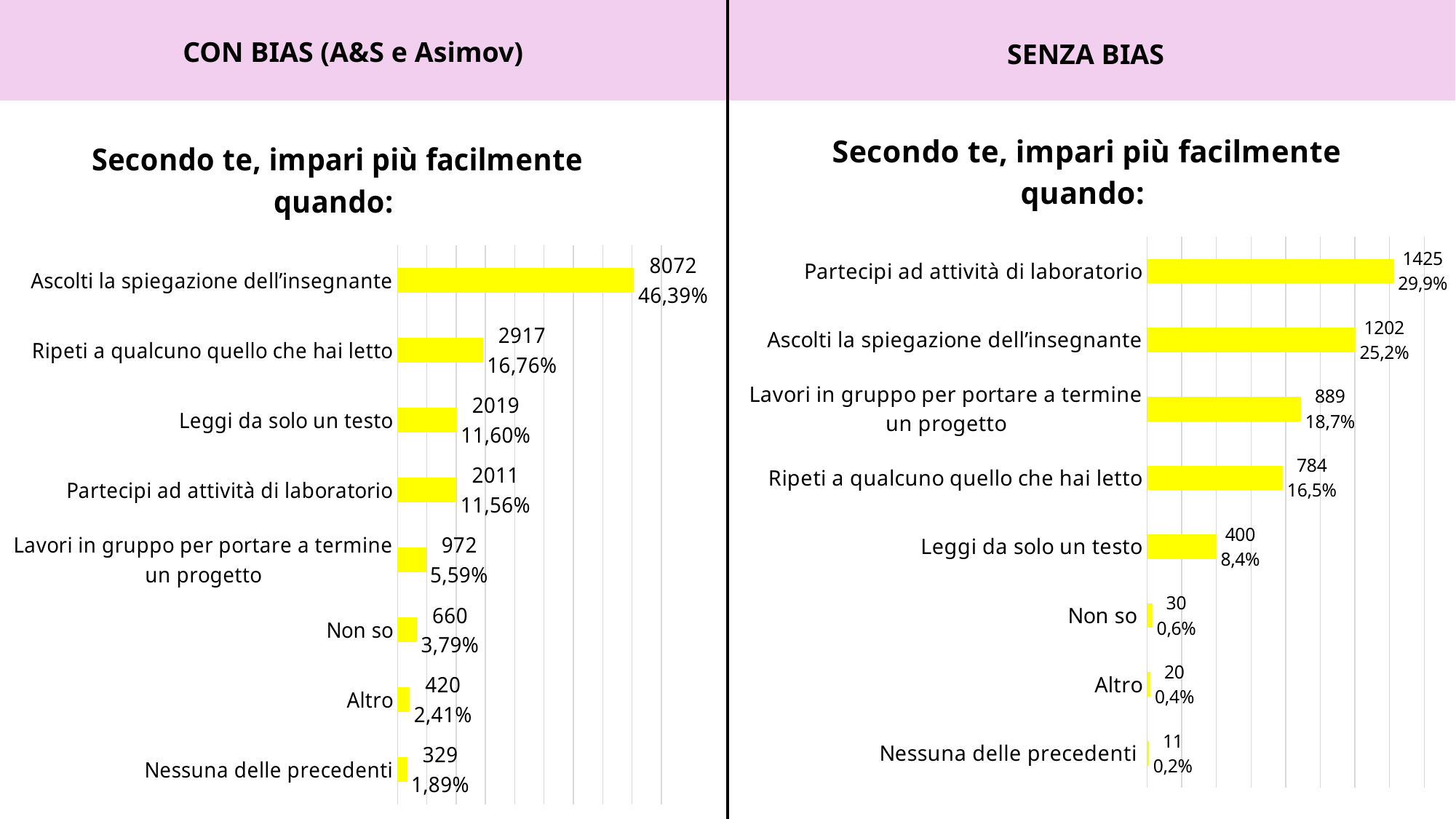
In the SENZA BIAS chart, what is the count for "Partecipi ad attività di laboratorio"? 1425 In the SENZA BIAS chart, which category has the lowest value? Nessuna delle precedenti In the CON BIAS chart, what percentage is shown for "Ripeti a qualcuno quello che hai letto"? 16,76% In the SENZA BIAS chart, what is the difference in count between "Partecipi ad attività di laboratorio" and "Ascolti la spiegazione dell'insegnante"? 223 What colour are the bars in the CON BIAS chart? Yellow In the SENZA BIAS chart, which is larger: "Ripeti a qualcuno quello che hai letto" or "Leggi da solo un testo"? Ripeti a qualcuno quello che hai letto What type of chart is the SENZA BIAS chart? Bar chart In the CON BIAS chart, which category has the highest value? Ascolti la spiegazione dell'insegnante In the CON BIAS chart, what is the count for "Ascolti la spiegazione dell'insegnante"? 8072 In the SENZA BIAS chart, what percentage is shown for "Lavori in gruppo per portare a termine un progetto"? 18,7% How many categories does the CON BIAS chart show? 8 In the CON BIAS chart, what is the difference in count between "Ripeti a qualcuno quello che hai letto" and "Leggi da solo un testo"? 898